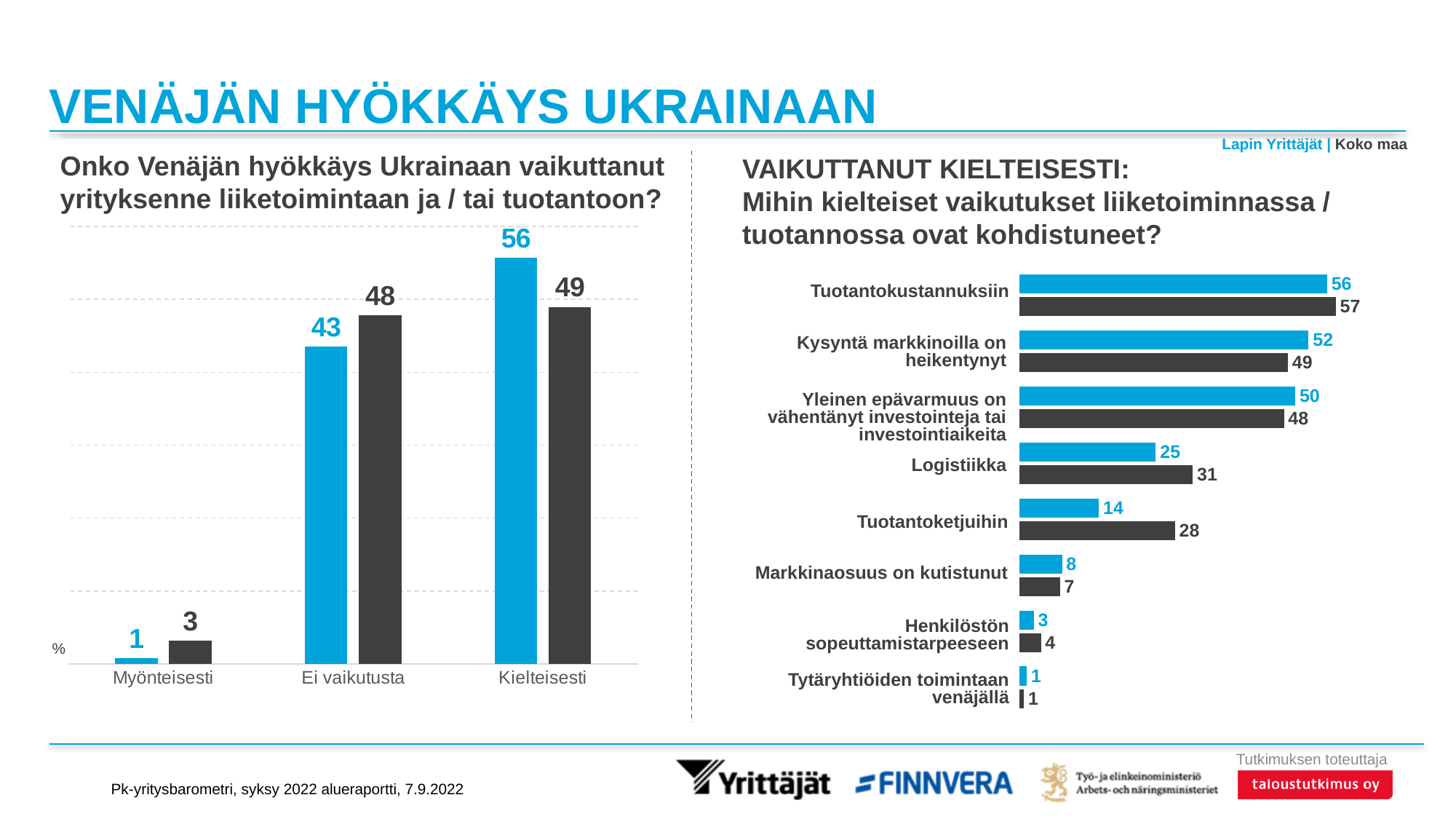
In the left chart (Onko Venäjän hyökkäys Ukrainaan vaikuttanut...), what is the difference between the Lapin Yrittäjät and Koko maa values for Kielteisesti? 7 How many series does the legend list for the charts on this slide? 2 In the right chart (Mihin kielteiset vaikutukset...), what is the Koko maa value for Logistiikka? 31 In the right chart (Mihin kielteiset vaikutukset...), how many categories are listed? 8 What kind of chart is the left chart (Onko Venäjän hyökkäys Ukrainaan vaikuttanut...)? Bar chart In the right chart (Mihin kielteiset vaikutukset...), what is the Lapin Yrittäjät value for Tuotantoketjuihin? 14 In the left chart (Onko Venäjän hyökkäys Ukrainaan vaikuttanut...), what is the Koko maa value for Ei vaikutusta? 48 In the left chart (Onko Venäjän hyökkäys Ukrainaan vaikuttanut...), what is the Lapin Yrittäjät value for Kielteisesti? 56 In the right chart (Mihin kielteiset vaikutukset...), which is larger for Tuotantoketjuihin: the Lapin Yrittäjät value or the Koko maa value? Koko maa In the left chart (Onko Venäjän hyökkäys Ukrainaan vaikuttanut...), how many categories are shown on the x axis? 3 In the right chart (Mihin kielteiset vaikutukset...), which category has the highest Lapin Yrittäjät value? Tuotantokustannuksiin In the left chart (Onko Venäjän hyökkäys Ukrainaan vaikuttanut...), which category has the lowest Lapin Yrittäjät value? Myönteisesti